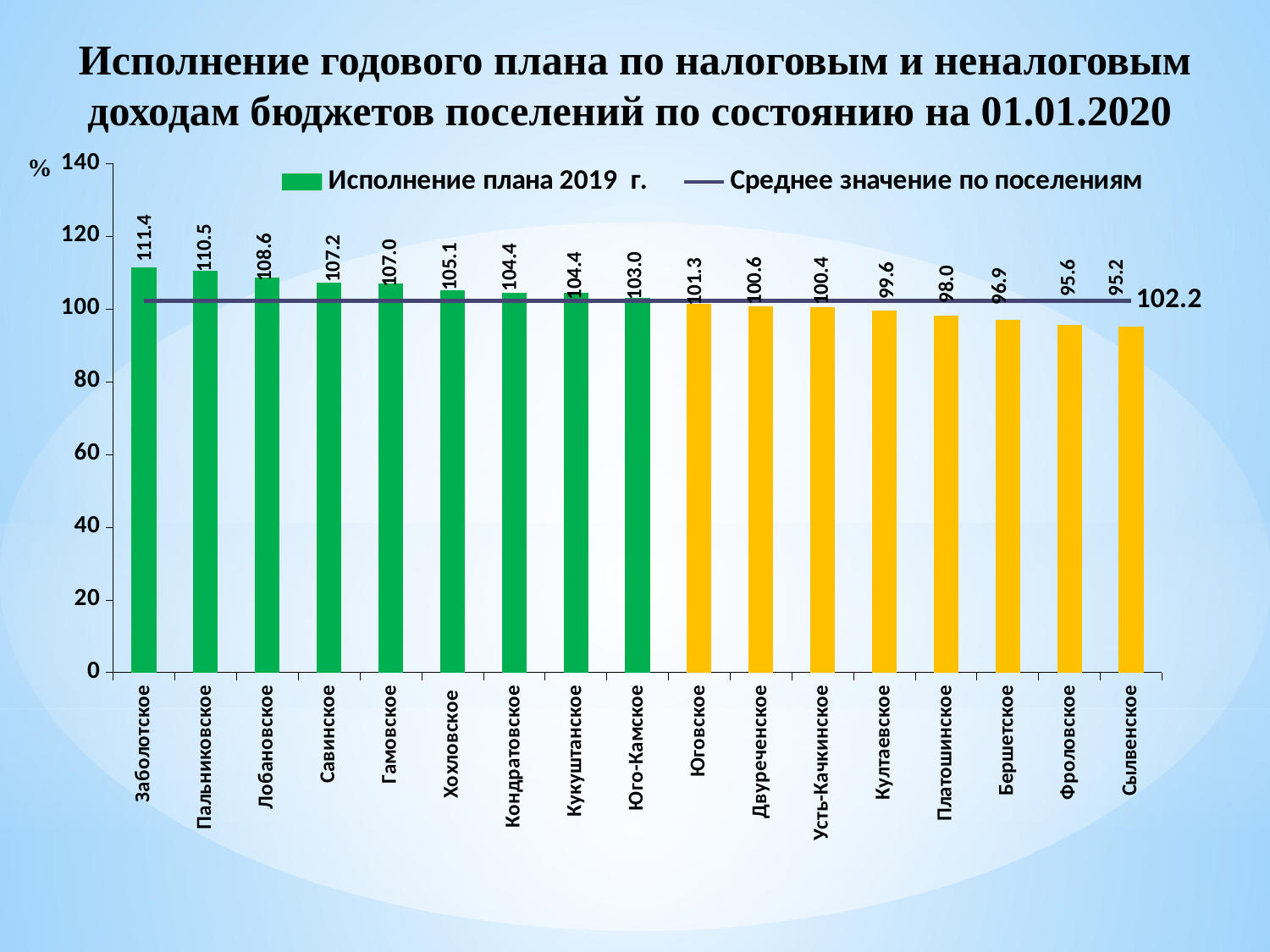
What is the plan execution value for Гамовское? 107.0 What kind of chart is shown on the slide? Bar chart Which settlement has the lowest plan execution value? Сылвенское What is the plan execution value for Заболотское? 111.4 How many settlements are shown on the chart? 17 What is the difference between the values for Заболотское and Сылвенское? 16.2 Do the bar values rise or fall from left to right along the x axis? Fall What is the average value across settlements shown by the horizontal line? 102.2 Which has a higher value, Лобановское or Платошинское? Лобановское How many series does the legend list? 2 Which settlement has the highest plan execution value? Заболотское What is the plan execution value for Сылвенское? 95.2